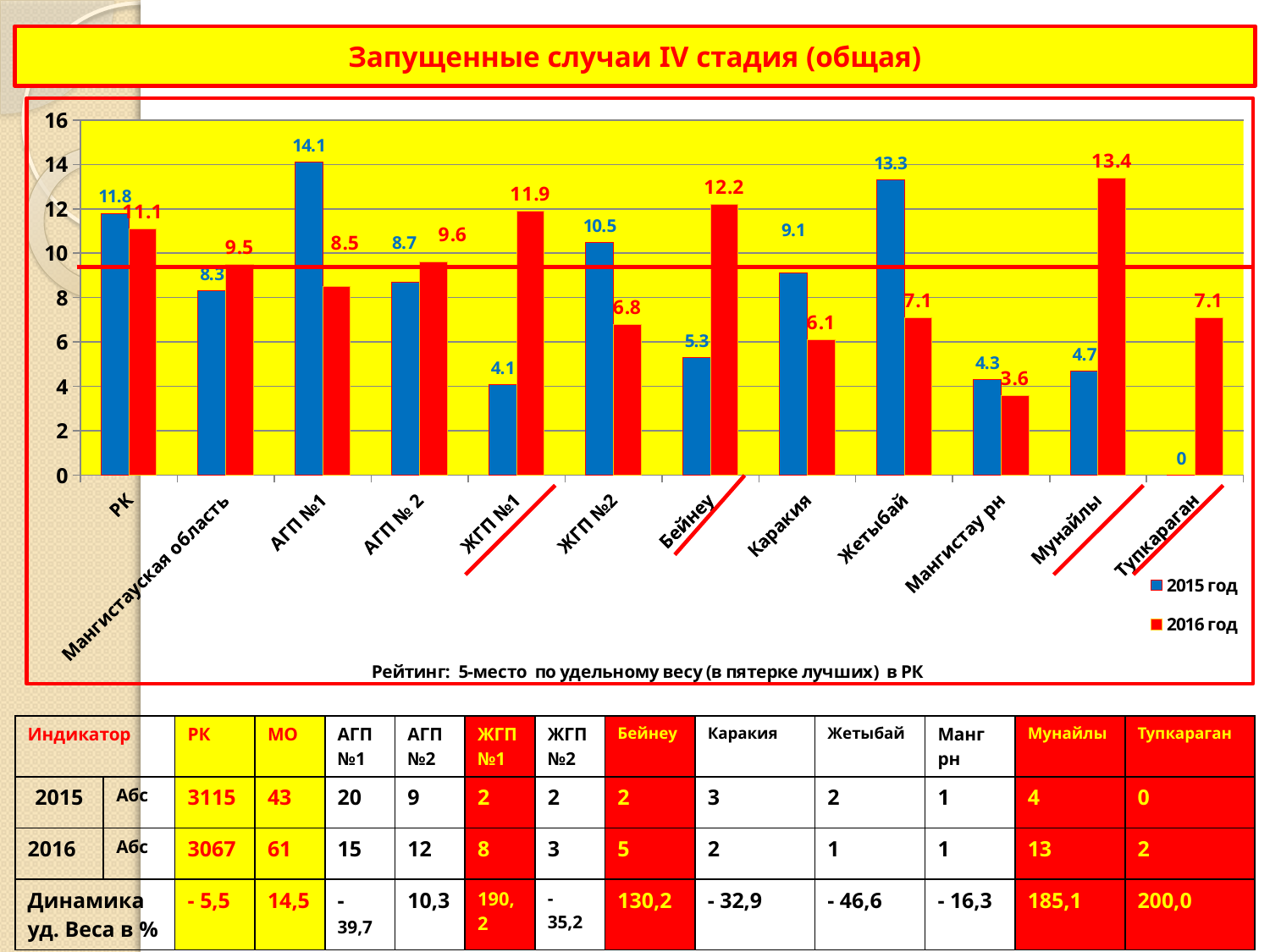
What is the value for Тупкараган in the 2015 год series? 0 How many categories are shown on the x axis of the chart? 12 What is the difference between the 2016 год and 2015 год values for Мунайлы? 8.7 What is the title of the chart? Запущенные случаи IV стадия (общая) What is the value for Бейнеу in the 2016 год series? 12.2 What type of chart is shown on the slide? bar chart How many series does the chart legend list? 2 Which category has the highest value in the 2016 год series? Мунайлы For Жетыбай, which series has the larger value, 2015 год or 2016 год? 2015 год Which category has the lowest value in the 2016 год series? Мангистау рн Which category has the highest value in the 2015 год series? АГП №1 What is the value for АГП №1 in the 2015 год series? 14.1